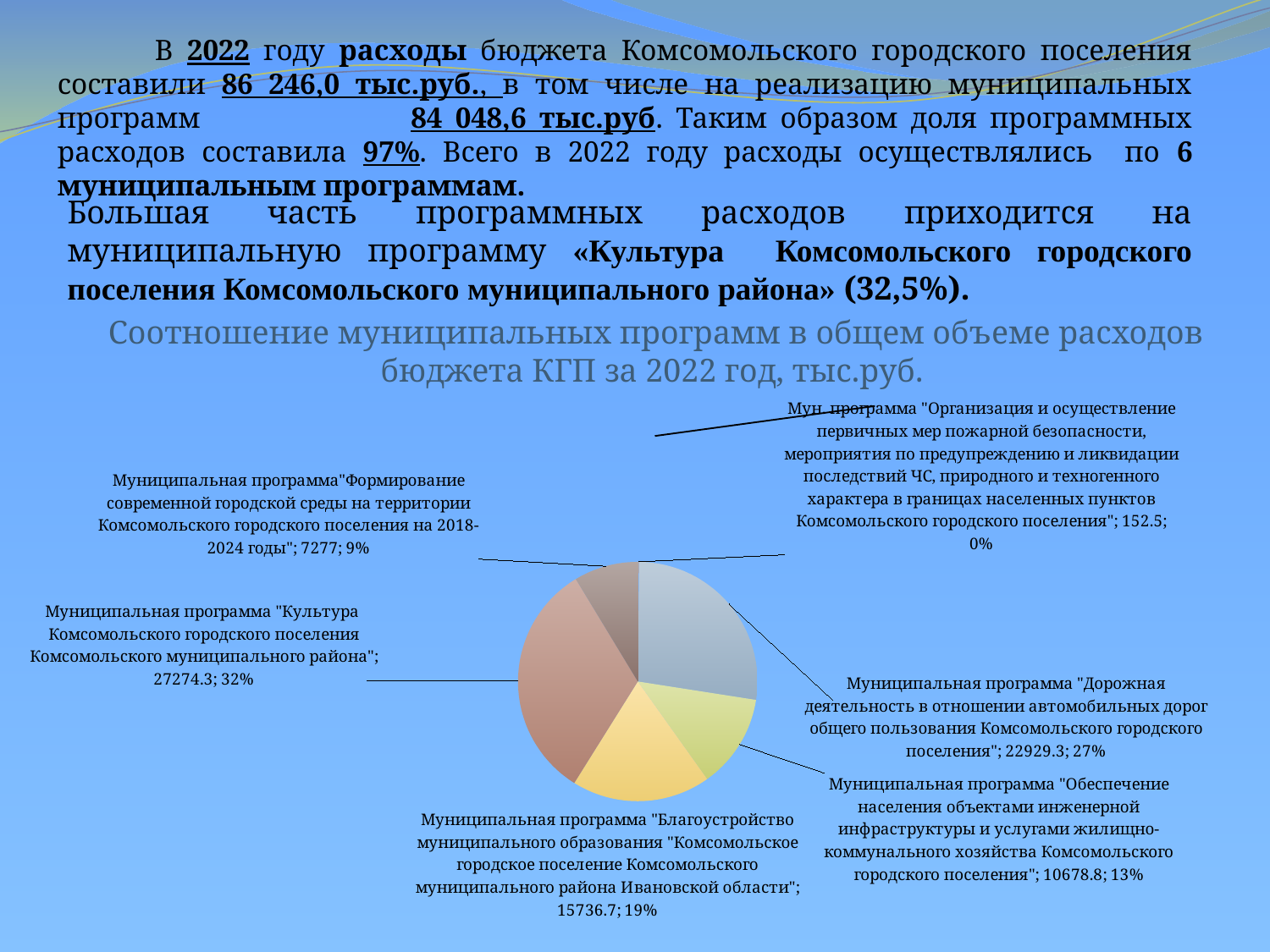
What is the value for the programme "Благоустройство муниципального образования "Комсомольское городское поселение Комсомольского муниципального района Ивановской области"? 15736.7 What kind of chart is shown on the slide? pie chart Which is larger: the value for the "Благоустройство" programme or the value for the "Обеспечение населения объектами инженерной инфраструктуры" programme? Благоустройство (15736.7) What is the title of the chart? Соотношение муниципальных программ в общем объеме расходов бюджета КГП за 2022 год, тыс.руб. What is the difference between the value for the "Культура" programme and the value for the "Дорожная деятельность" programme? 4345 Which programme has the smallest slice of the pie? Мун. программа "Организация и осуществление первичных мер пожарной безопасности..." (152.5; 0%) What share of the pie does the programme "Дорожная деятельность в отношении автомобильных дорог общего пользования Комсомольского городского поселения" take? 27% What is the value for the programme "Обеспечение населения объектами инженерной инфраструктуры и услугами жилищно-коммунального хозяйства Комсомольского городского поселения"? 10678.8 How many slices does the pie chart have? 6 What is the value for the municipal programme "Культура Комсомольского городского поселения Комсомольского муниципального района"? 27274.3 Which programme has the largest slice of the pie? Муниципальная программа "Культура Комсомольского городского поселения Комсомольского муниципального района" What share of the pie does the programme "Формирование современной городской среды на территории Комсомольского городского поселения на 2018-2024 годы" take? 9%